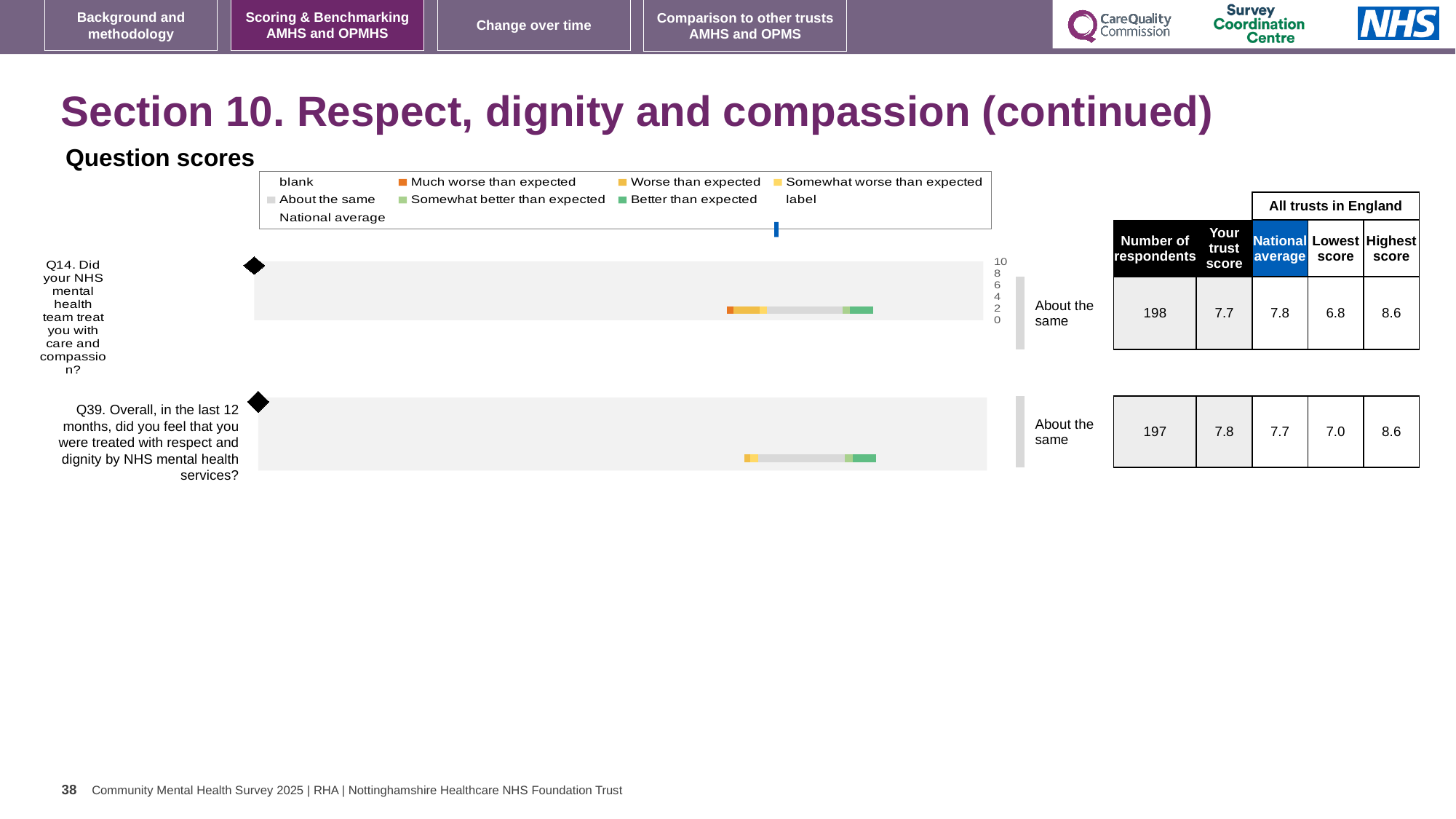
What is the lowest score among all trusts in England for Q39? 7.0 What is the highest score among all trusts in England for Q14? 8.6 What is the difference between the trust score and the national average for Q39? 0.1 Which legend entry is shown with an orange marker? Much worse than expected What is the difference between the highest score and the lowest score for Q14? 1.8 What is the trust score for Q14 (care and compassion)? 7.7 Which question has the higher trust score, Q14 or Q39? Q39 How many questions (categories) are plotted in the Question scores chart? 2 What benchmark category label is shown next to the bar for Q39? About the same What is the national average for Q39 (respect and dignity)? 7.7 How many respondents answered Q14? 198 What kind of chart is shown under "Question scores"? bar chart